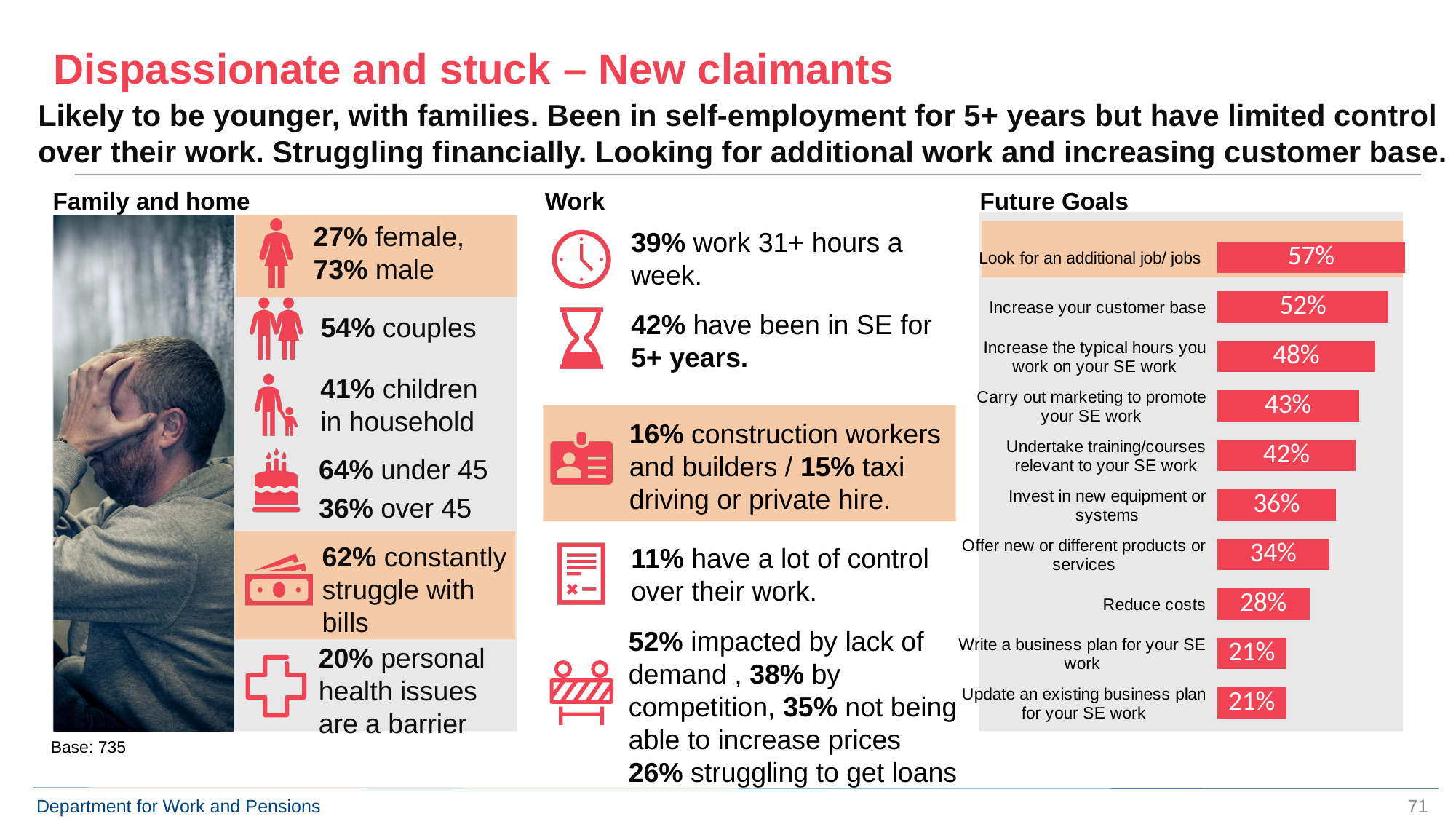
In the Future Goals chart, what is the value for 'Invest in new equipment or systems'? 36% In the Future Goals chart, what percentage of new claimants say they will look for an additional job or jobs? 57% In the Future Goals chart, what is the lowest percentage shown? 21% In the Future Goals chart, which future goal has the highest percentage? Look for an additional job/ jobs How many future goals are listed in the Future Goals chart? 10 In the Future Goals chart, what is the difference in percentage points between 'Look for an additional job/ jobs' and 'Increase your customer base'? 5 percentage points In the Future Goals chart, what is the difference in percentage points between 'Carry out marketing to promote your SE work' and 'Reduce costs'? 15 percentage points What is the title of the chart on the right side of the slide? Future Goals In the Future Goals chart, which is larger: 'Undertake training/courses relevant to your SE work' or 'Offer new or different products or services'? Undertake training/courses relevant to your SE work In the Future Goals chart, what is the value for 'Increase your customer base'? 52% In the Future Goals chart, what percentage plan to reduce costs? 28% What type of chart is used for the Future Goals section? Bar chart